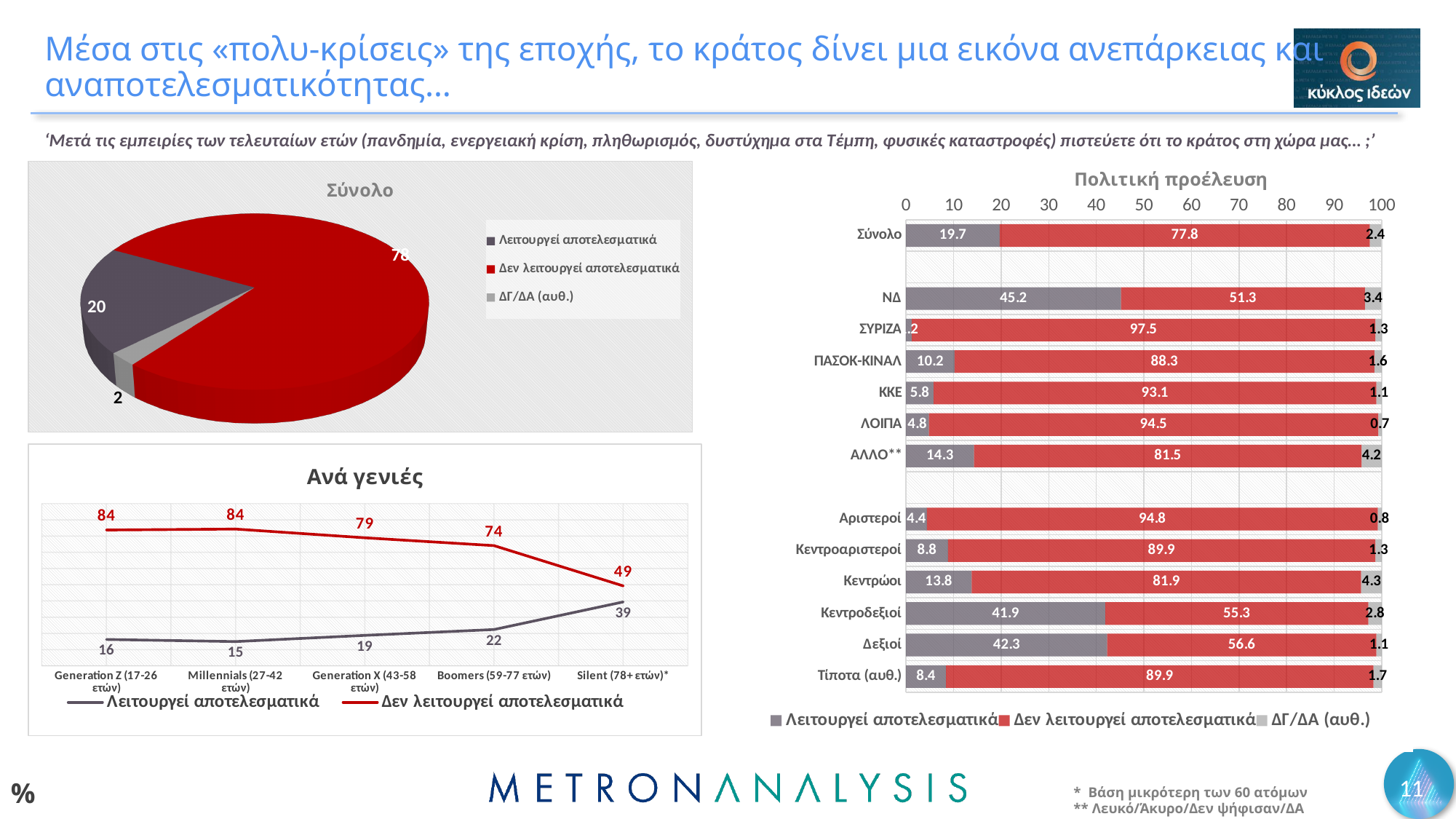
What kind of chart is the one titled Πολιτική προέλευση? bar chart In the chart titled Πολιτική προέλευση, which category has the highest Λειτουργεί αποτελεσματικά value? ΝΔ In the chart titled Ανά γενιές, does the Δεν λειτουργεί αποτελεσματικά line rise or fall from Generation Z to Silent? fall In the chart titled Ανά γενιές, how many series does the legend list? 2 In the chart titled Ανά γενιές, how many generation categories are shown on the x axis? 5 In the chart titled Πολιτική προέλευση, which has the larger Λειτουργεί αποτελεσματικά value, Κεντρώοι or Κεντροαριστεροί? Κεντρώοι In the chart titled Ανά γενιές, what is the difference between the two series for Silent (78+ ετών)*? 10 In the chart titled Πολιτική προέλευση, what is the Δεν λειτουργεί αποτελεσματικά value for ΣΥΡΙΖΑ? 97.5 In the pie chart titled Σύνολο, what share is labelled for Δεν λειτουργεί αποτελεσματικά? 78 In the chart titled Πολιτική προέλευση, what is the total of the stacked bar for ΚΚΕ? 100 In the chart titled Ανά γενιές, what is the value of Δεν λειτουργεί αποτελεσματικά for Boomers (59-77 ετών)? 74 In the pie chart titled Σύνολο, which category has the smallest slice? ΔΓ/ΔΑ (αυθ.)